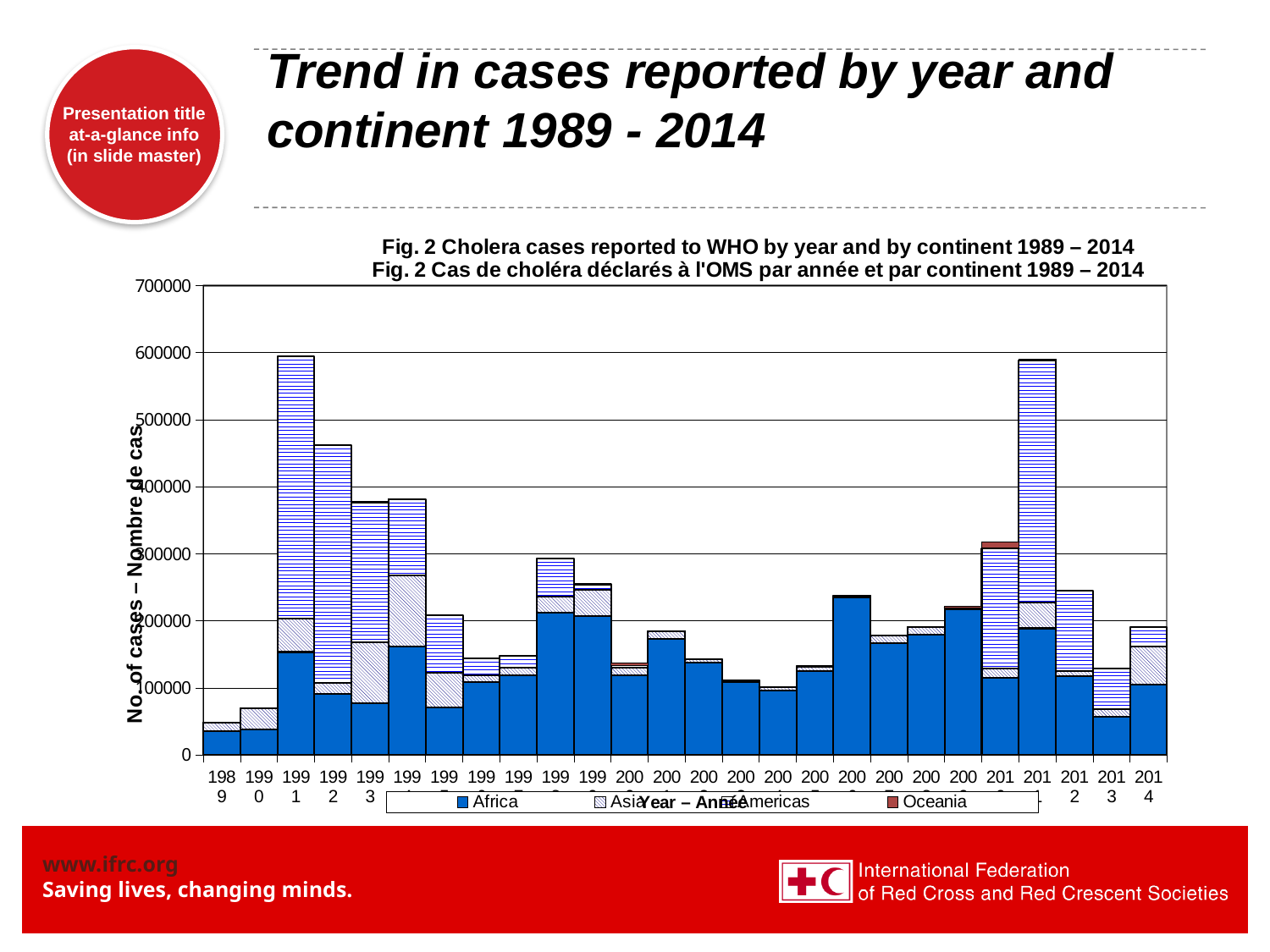
Which year has the larger total number of cases, 1991 or 1992? 1991 How many years are plotted along the x axis of the chart? 26 Is the total number of cases for 1992 greater or less than 400000? greater Is the total number of cases for 1991 greater or less than 500000? greater Is the total number of cases for 1989 greater or less than 100000? less What kind of chart is shown on the slide? Stacked bar chart How many series does the chart legend list? 4 Which year has the lowest total number of cholera cases in the chart? 1989 Do the total cases rise or fall from 1991 to 1993? fall Which year has the larger total number of cases, 2012 or 2013? 2012 Which continents are listed in the chart legend? Africa, Asia, Americas, Oceania